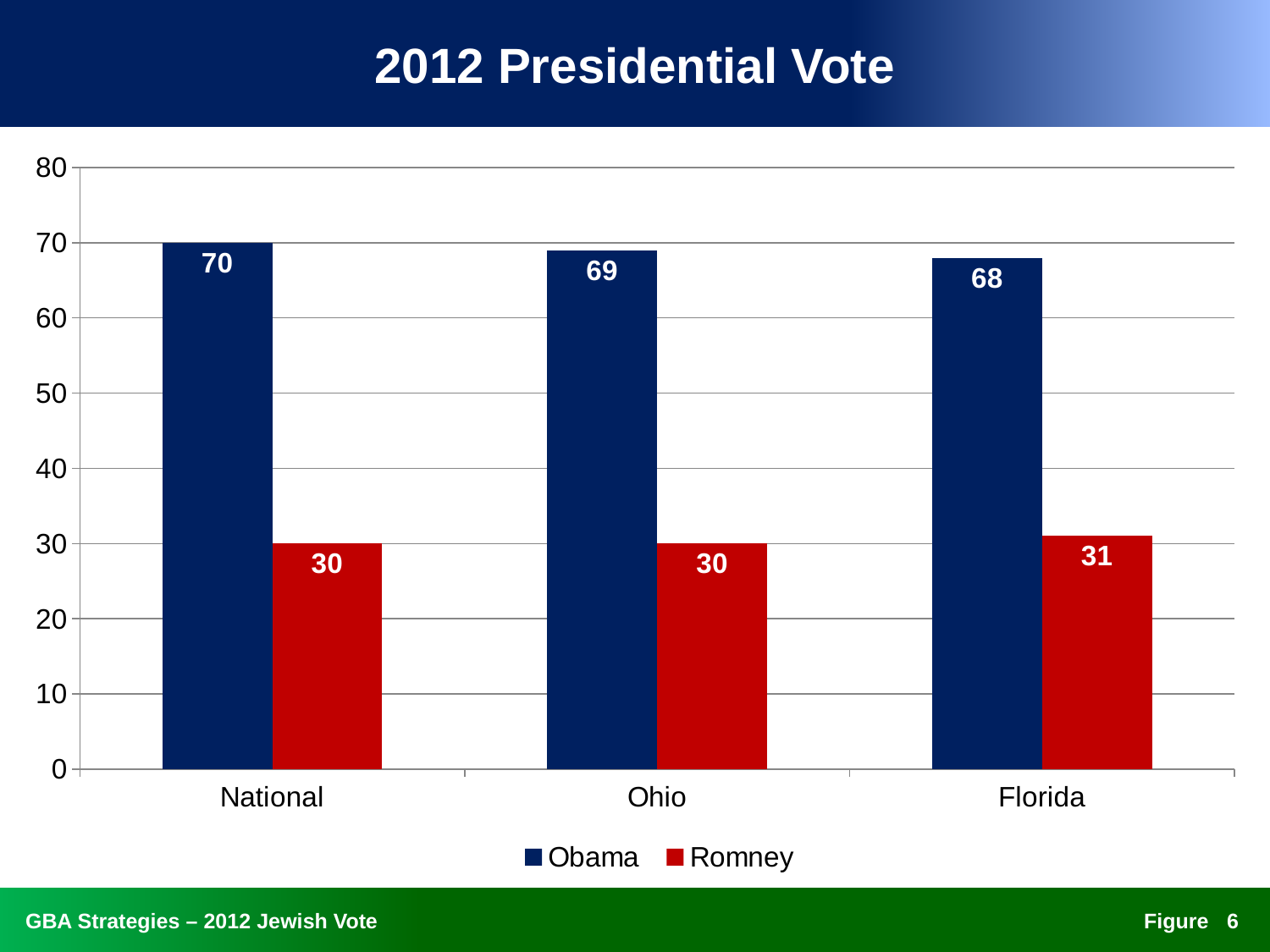
How many series does the legend list? 2 What is the value for Romney in Florida? 31 What is the title of the chart? 2012 Presidential Vote In which category is the Obama value lowest? Florida What is the difference between the Obama and Romney values in Ohio? 39 What is the difference between the Obama values for National and Florida? 2 How many categories are shown on the x axis? 3 Which is larger in Florida, the Obama value or the Romney value? Obama What is the value for Obama in Ohio? 69 In which category is the Obama value highest? National What is the value for Obama in the National category? 70 What kind of chart is shown on the slide? Bar chart